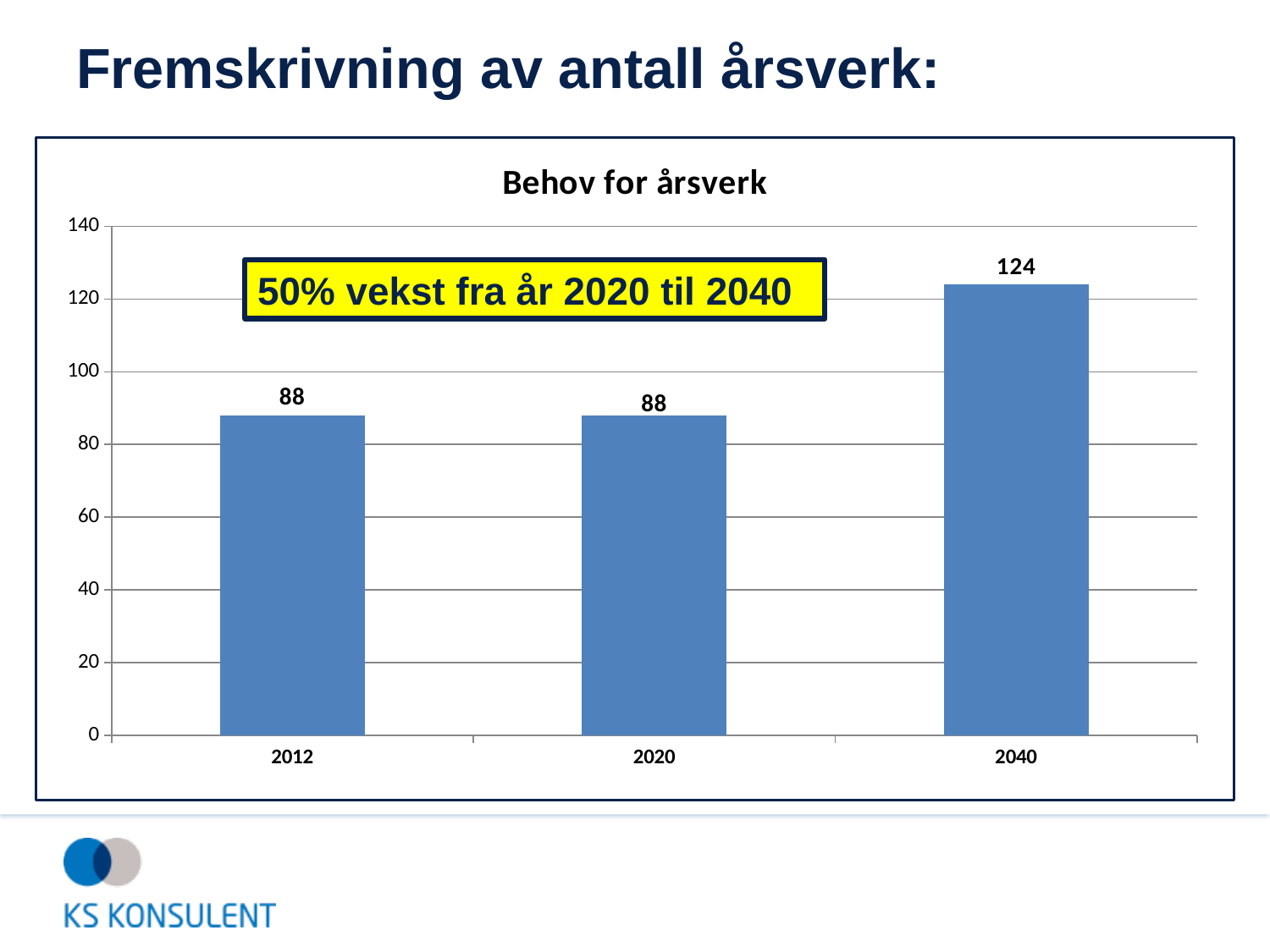
Is the value for 2012 greater or less than 100? less Which year has the highest value? 2040 What kind of chart is shown? bar chart What is the value for 2020? 88 Is the value for 2040 greater or less than 120? greater Which is larger, the value for 2040 or the value for 2012? 2040 What is the difference between the values for 2040 and 2020? 36 How many years are shown on the x axis? 3 What is the value for 2012? 88 What is the value for 2040? 124 What does the yellow box on the chart say? 50% vekst fra år 2020 til 2040 What is the title of the chart? Behov for årsverk